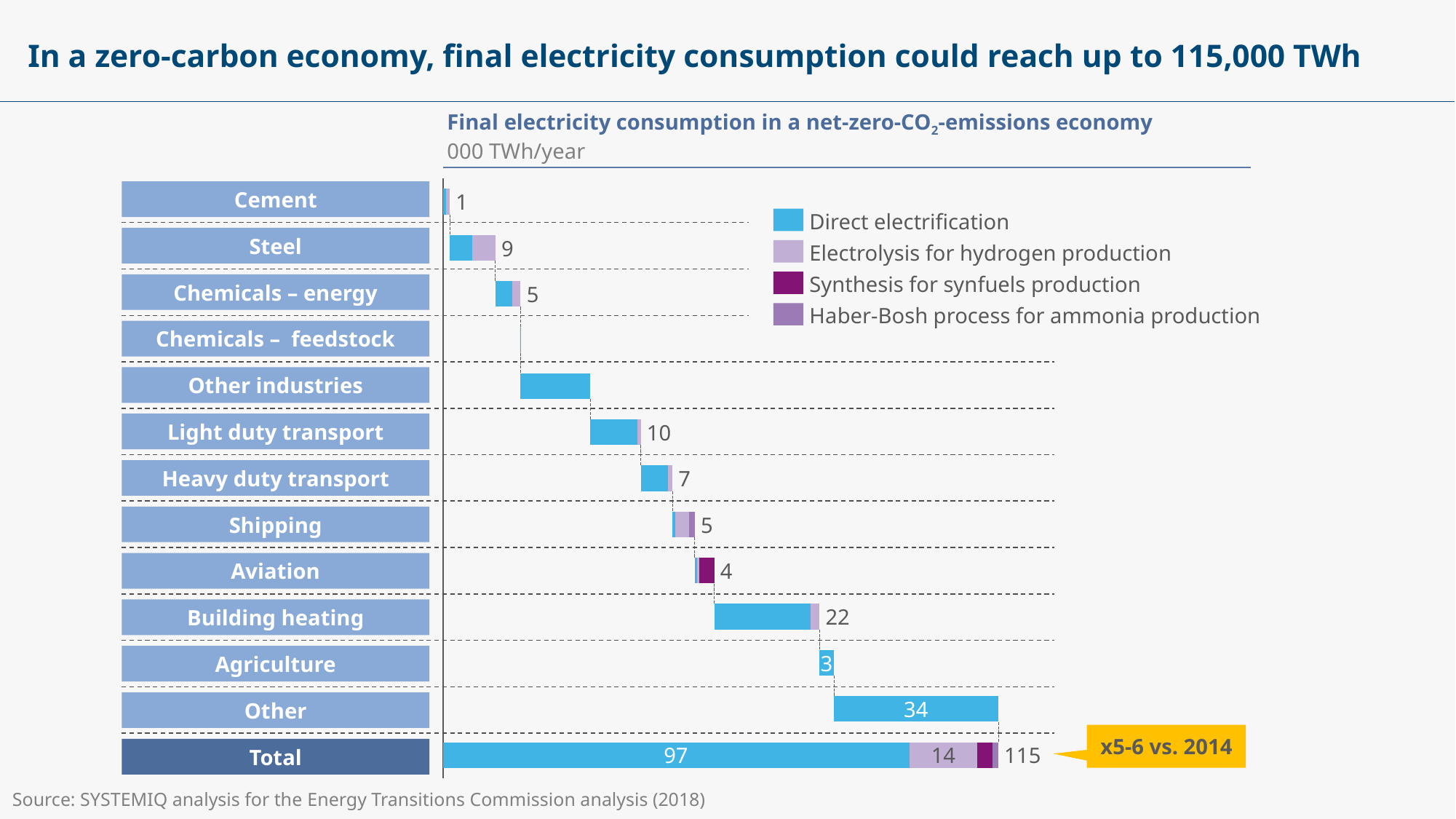
What is the value for Building heating? 22 How many series does the legend list? 4 What is the Direct electrification value in the Total bar? 97 What is the Electrolysis for hydrogen production value in the Total bar? 14 What is the value for Other? 34 What is the difference between the values for Other and Building heating? 12 What is the value for Light duty transport? 10 What is the total final electricity consumption shown at the end of the Total bar? 115 Which is larger, the value for Steel or the value for Heavy duty transport? Steel Which labelled category has the lowest value? Cement What unit is shown under the chart title? 000 TWh/year Excluding the Total bar, which category has the highest value? Other